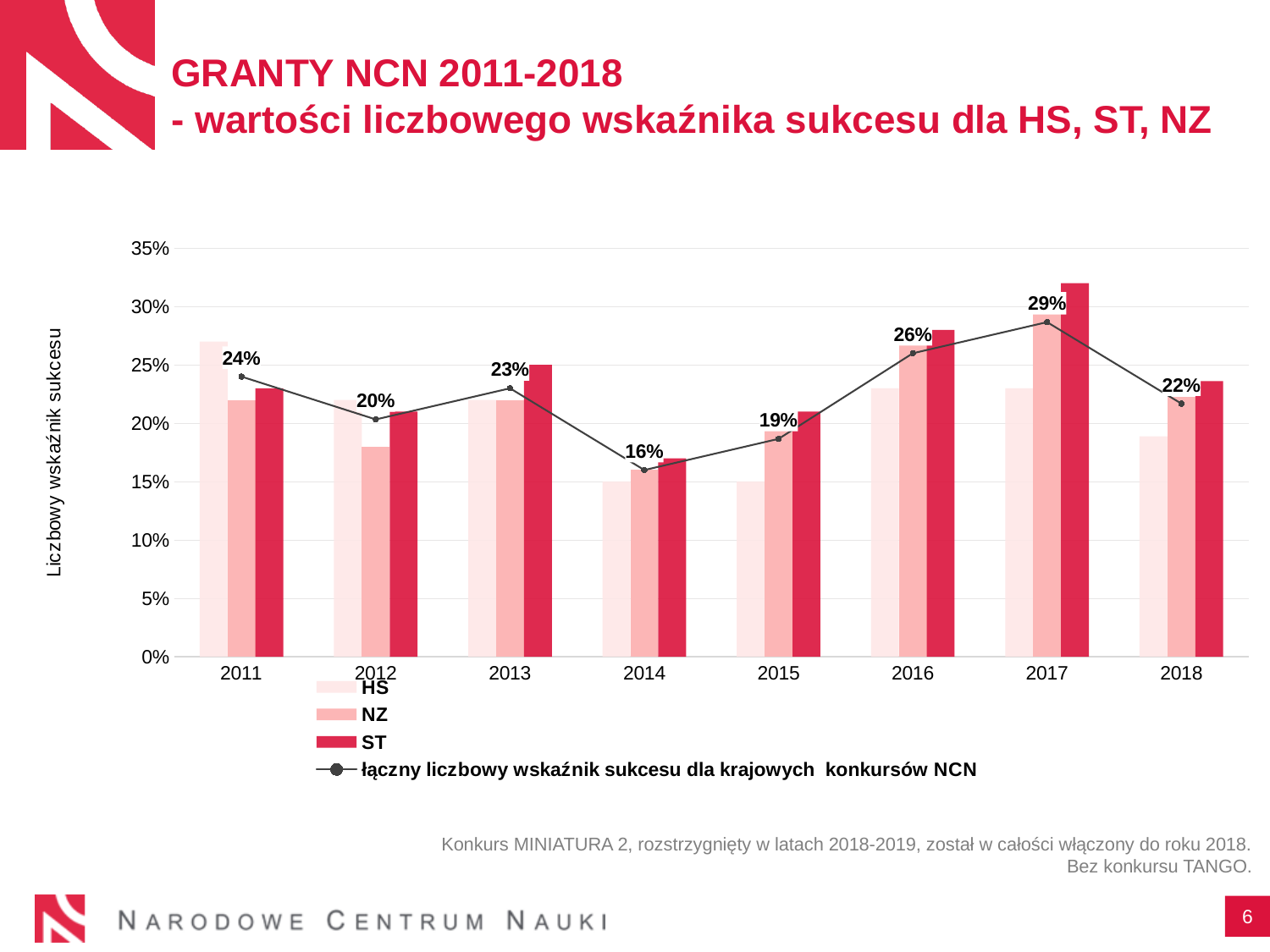
In which year is the overall success rate line at its highest? 2017 Is the value of the NZ bar for 2012 greater or less than 20%? less Which year has a higher overall success rate, 2011 or 2016? 2016 Is the value of the ST bar for 2017 greater or less than 30%? greater What is the overall success rate (łączny liczbowy wskaźnik sukcesu) shown for 2014? 16% Does the overall success rate line rise or fall from 2014 to 2017? rise What is the overall success rate (łączny liczbowy wskaźnik sukcesu) shown for 2017? 29% How many series does the legend list? 4 In which year is the overall success rate line at its lowest? 2014 Is the value of the HS bar for 2011 greater or less than 25%? greater How many years are shown on the x axis of the chart? 8 What is the difference between the overall success rate in 2017 and in 2014? 13 percentage points